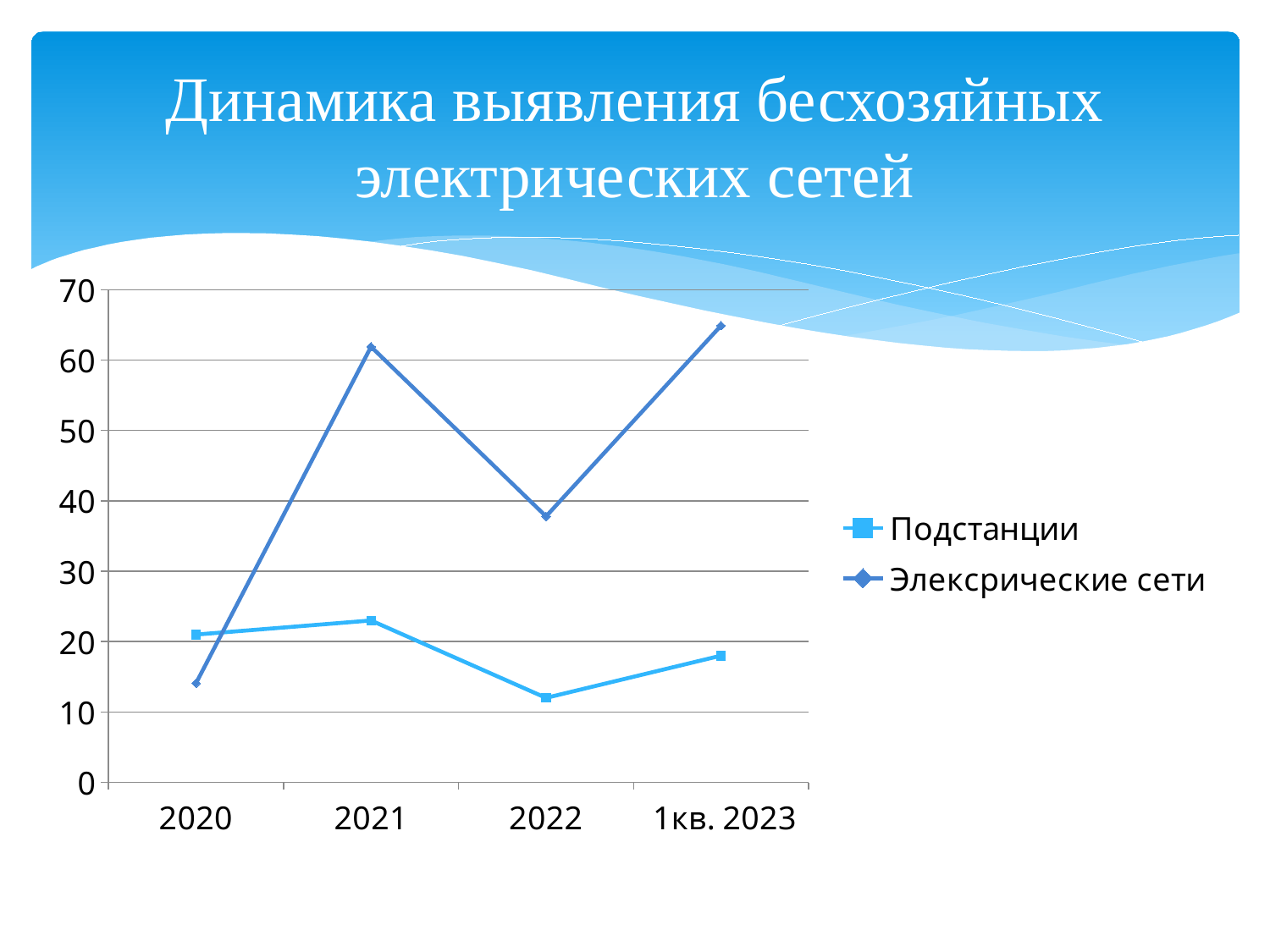
Which series has the larger value in 2020, Подстанции or Элексрические сети? Подстанции Is the value for Подстанции in 2022 greater or less than 20? less What is the title of the slide containing the chart? Динамика выявления бесхозяйных электрических сетей Is the value for Элексрические сети in 2021 greater or less than 60? greater How many points along the x axis does each line have? 4 How many series does the legend list? 2 What kind of chart is shown on the slide? line chart At which x-axis category does the Подстанции line reach its lowest value? 2022 Does the Элексрические сети line rise or fall from 2021 to 2022? fall In which year does the Элексрические сети line reach its lowest value? 2020 Which series is plotted with square markers? Подстанции At which x-axis category does the Подстанции line reach its highest value? 2021